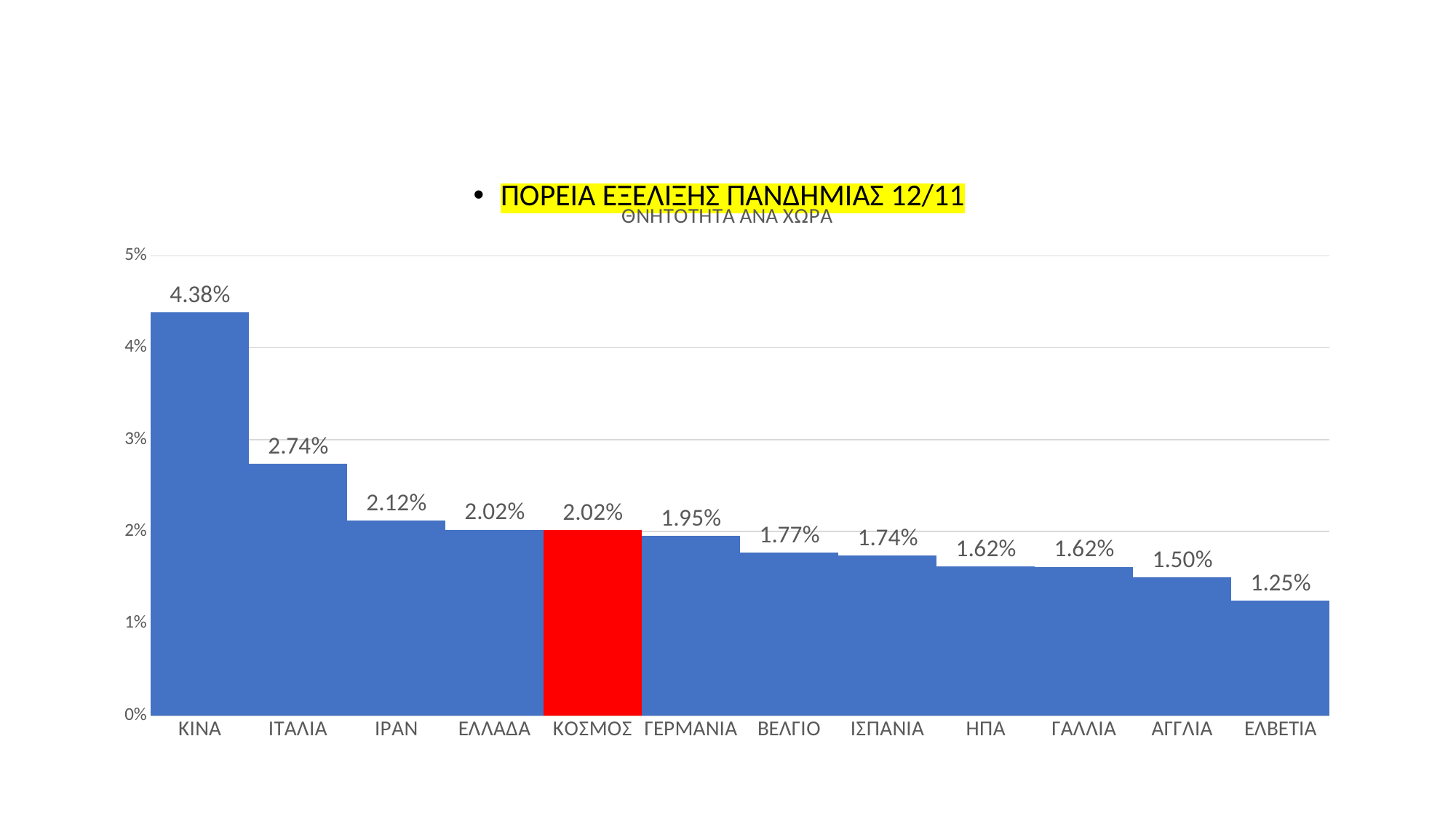
Which is larger, the value for ΙΡΑΝ or the value for ΒΕΛΓΙΟ? ΙΡΑΝ Is the value for ΙΤΑΛΙΑ greater or less than 3%? less What is the difference between the values for ΚΙΝΑ and ΙΤΑΛΙΑ? 1.64% Which bar is coloured red? ΚΟΣΜΟΣ Which category has the highest value? ΚΙΝΑ What is the value for ΓΕΡΜΑΝΙΑ? 1.95% Which category has the lowest value? ΕΛΒΕΤΙΑ What kind of chart is this? bar chart What is the value for ΚΟΣΜΟΣ? 2.02% Do the values rise or fall from left to right along the x axis? fall What is the value for ΚΙΝΑ? 4.38% How many categories are shown on the x axis? 12